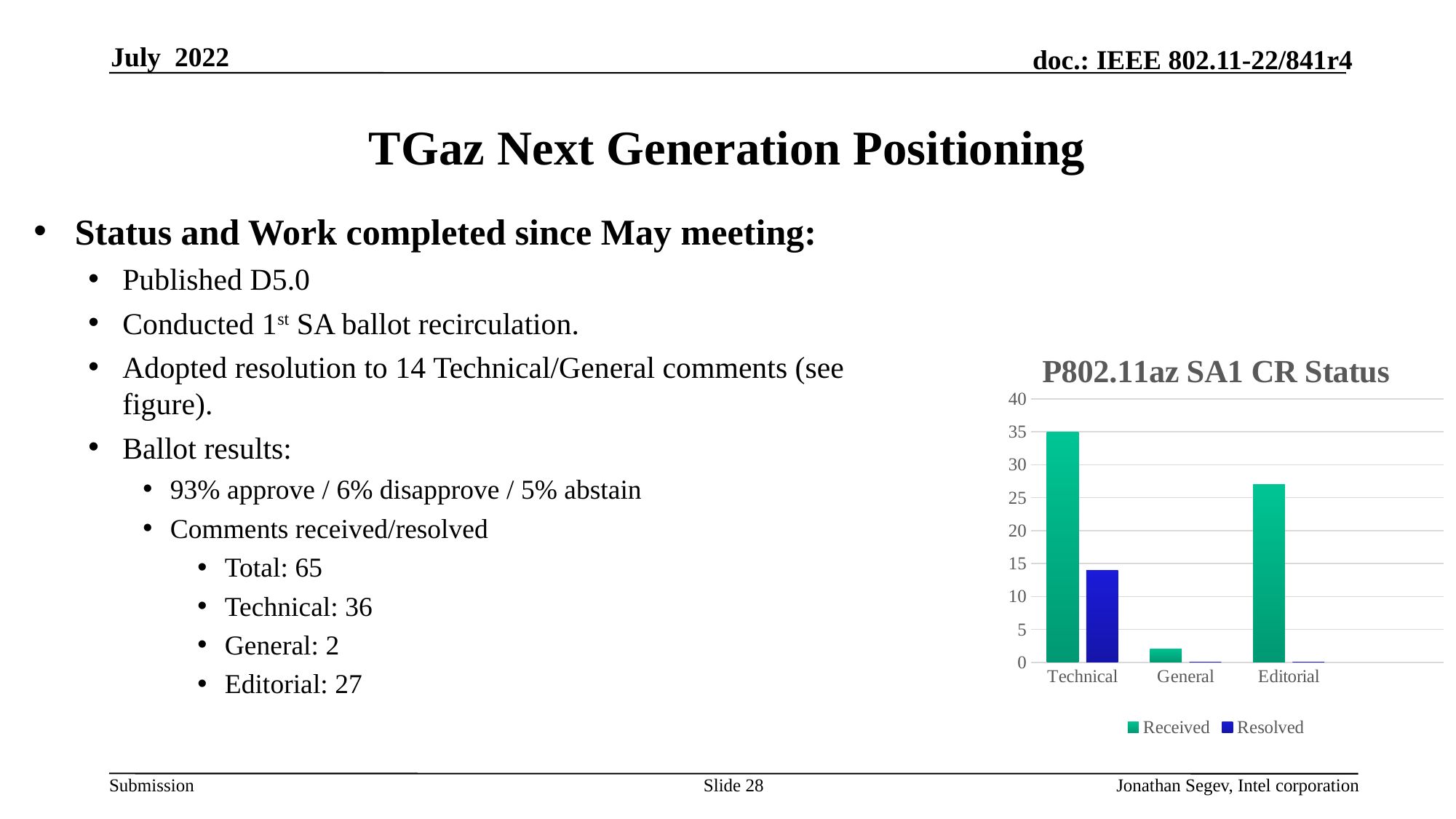
What type of chart is shown on the slide? bar chart How many categories are shown on the x axis of the chart? 3 Is the Received value for Technical greater or less than 30? greater What is the title of the chart? P802.11az SA1 CR Status Is the Resolved value for Technical greater or less than 10? greater Which category has the highest Received value? Technical Is the Received value for Editorial greater or less than 25? greater What are the two series named in the chart legend? Received and Resolved How many series does the chart legend list? 2 Which category has the lowest Received value? General For the Technical category, which is larger: the Received value or the Resolved value? Received